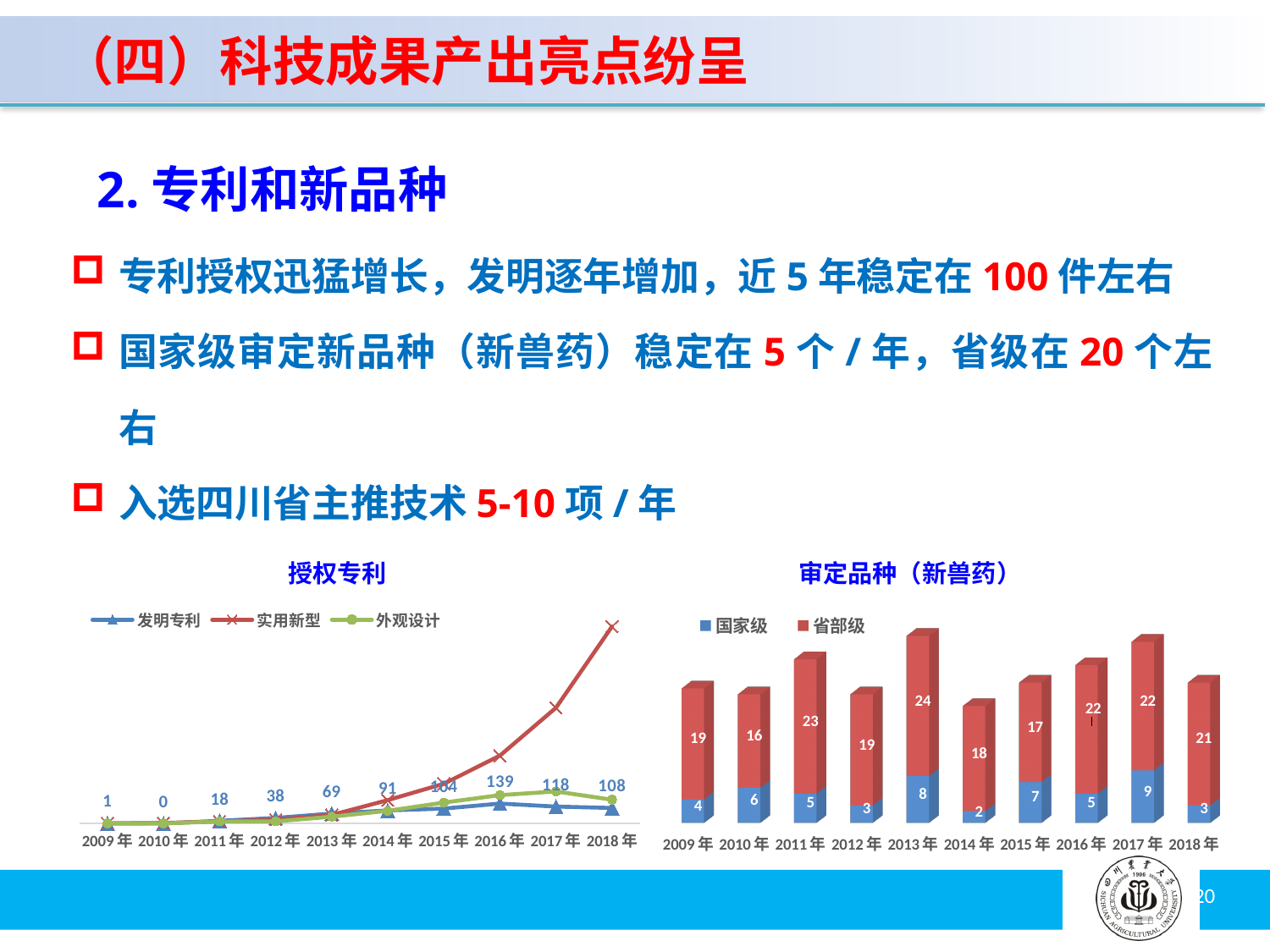
In the 授权专利 chart, which year has the highest labelled value for 发明专利? 2016年 In the 审定品种（新兽药） chart, what is the 国家级 value for 2017年? 9 In the 审定品种（新兽药） chart, what is the total of the stacked bar for 2011年? 28 In the 授权专利 chart, how many series does the legend list? 3 In the 审定品种（新兽药） chart, what is the 省部级 value for 2013年? 24 In the 审定品种（新兽药） chart, is the 省部级 value for 2011年 larger or smaller than that for 2010年? larger In the 授权专利 chart, what is the value of 发明专利 for 2016年? 139 In the 审定品种（新兽药） chart, which year has the lowest 国家级 value? 2014年 In the 授权专利 chart, what is the value of 发明专利 for 2014年? 91 In the 授权专利 chart, what is the difference between the 发明专利 values for 2016年 and 2018年? 31 In the 授权专利 chart, which series rises most steeply toward 2018年? 实用新型 What kind of chart is the 审定品种（新兽药） chart? stacked bar chart